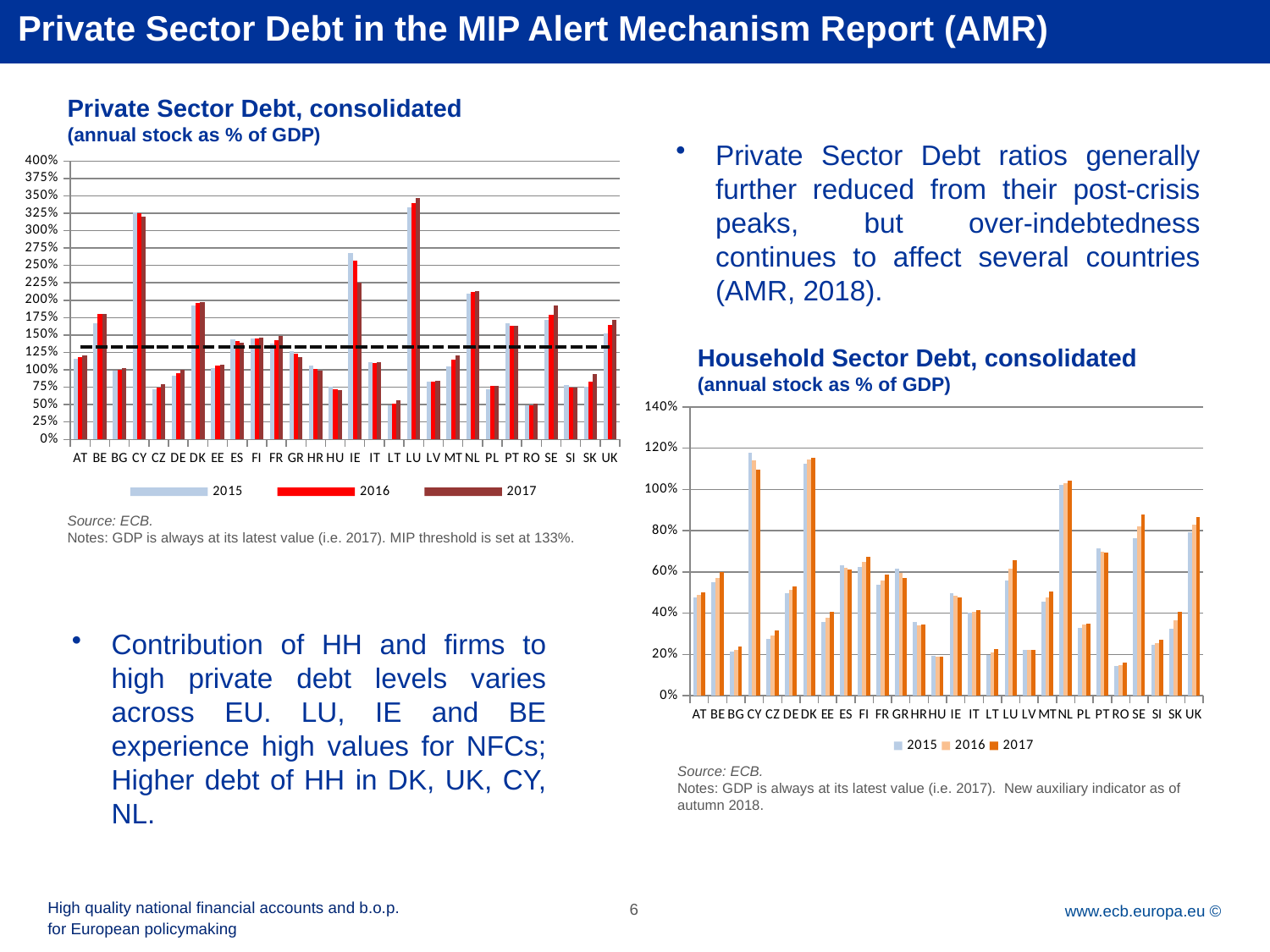
In the "Household Sector Debt, consolidated" chart, is the 2017 value for DK greater or less than 100%? greater In the "Private Sector Debt, consolidated" chart, which is larger for 2016: LU or IE? LU In the "Household Sector Debt, consolidated" chart, which country has the lowest 2017 value? RO In the "Household Sector Debt, consolidated" chart, is the 2017 value for BG greater or less than 40%? less According to the notes under the "Private Sector Debt, consolidated" chart, at what level is the MIP threshold set? 133% In the "Household Sector Debt, consolidated" chart, which is larger for 2017: NL or HU? NL What kind of chart is the "Private Sector Debt, consolidated" chart? bar chart In the "Private Sector Debt, consolidated" chart, which country has the highest 2016 value? LU How many countries are shown on the x axis of the "Private Sector Debt, consolidated" chart? 28 How many series does the legend of the "Household Sector Debt, consolidated" chart list? 3 In the "Private Sector Debt, consolidated" chart, is the 2016 value for CY greater or less than 300%? greater